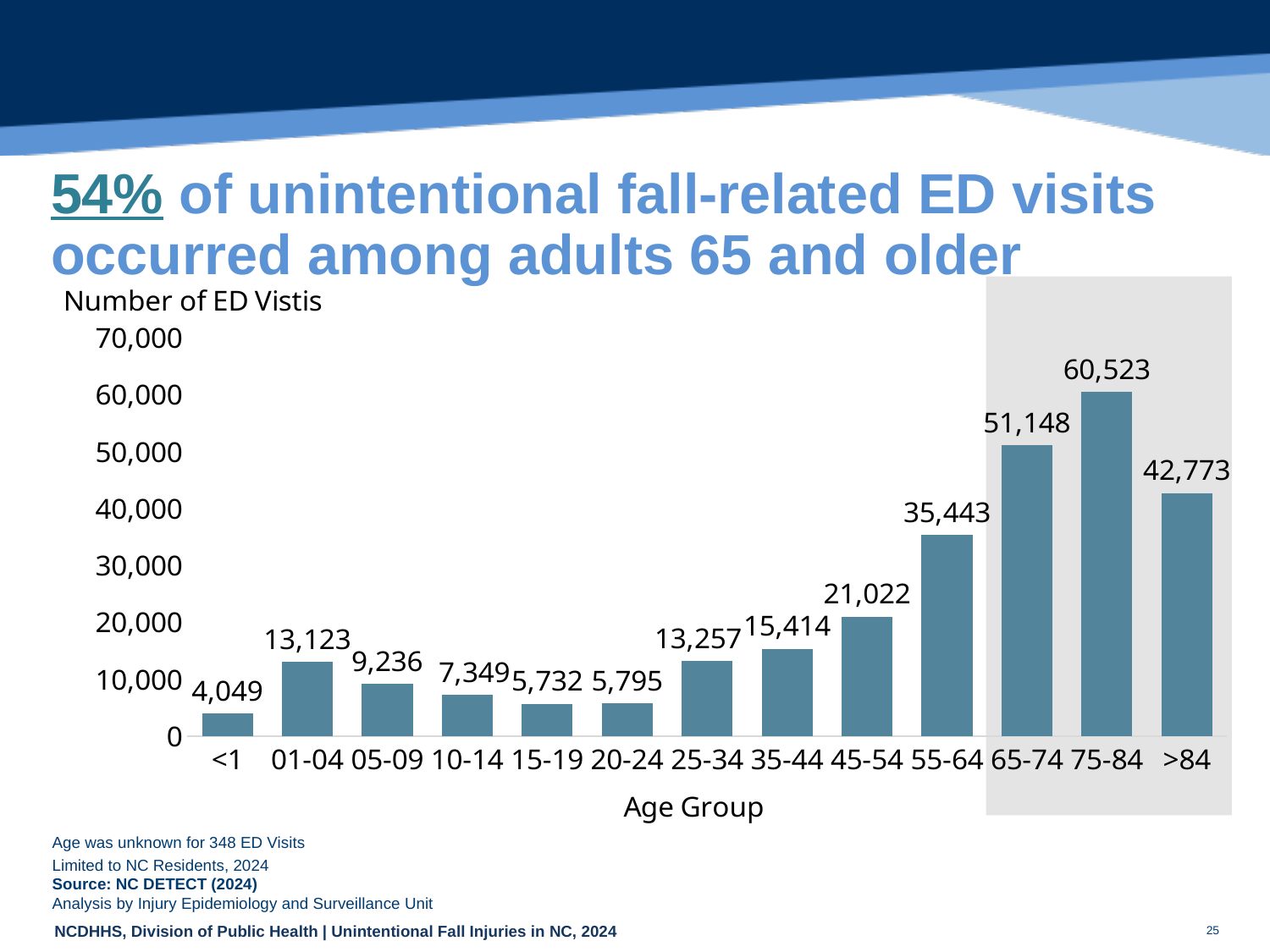
Which age group has more ED visits, 45-54 or 35-44? 45-54 What is the difference in ED visits between the 75-84 and 65-74 age groups? 9,375 What is the number of ED visits for the <1 age group? 4,049 How many age groups are shown on the x axis? 13 What is the difference in ED visits between the >84 and 55-64 age groups? 7,330 Which age group has the highest number of ED visits? 75-84 What is the number of ED visits for the 75-84 age group? 60,523 Do the values rise or fall from the 15-19 age group to the 75-84 age group? Rise Which age group has the lowest number of ED visits? <1 What is the number of ED visits for the 55-64 age group? 35,443 Is the value for the >84 age group greater or less than 40,000? greater What kind of chart is shown on the slide? Bar chart